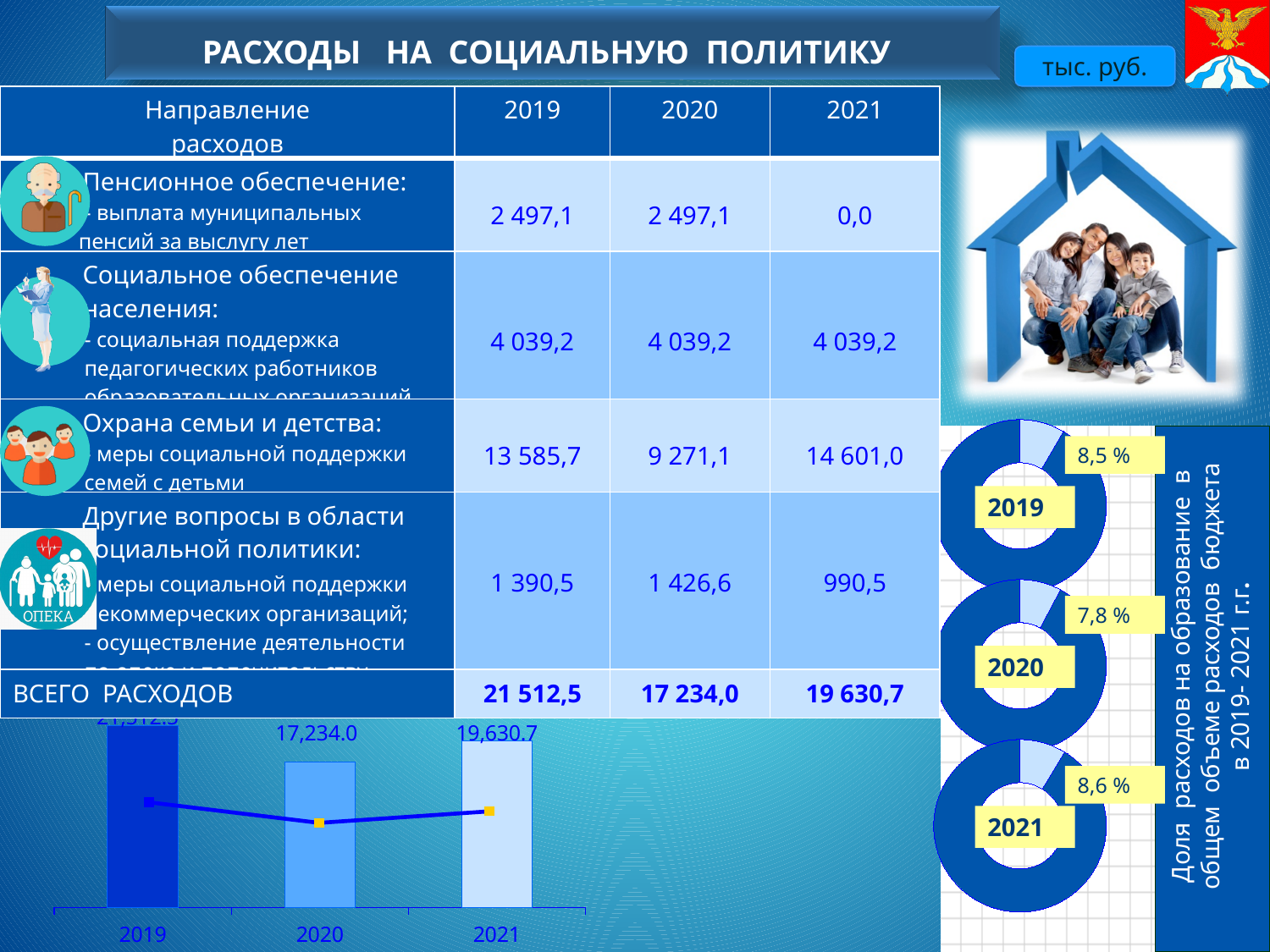
What kind of chart is shown at the bottom left of the slide? bar chart In the bar chart at the bottom left, what is the value for 2021? 19,630.7 In the bar chart at the bottom left, which year has the lowest value? 2020 In the bar chart at the bottom left, which year has the tallest bar? 2019 In the bar chart at the bottom left, what is the value for 2020? 17,234.0 In the bar chart at the bottom left, does the value rise or fall from 2020 to 2021? rise In the bar chart at the bottom left, how many years are shown on the x axis? 3 In the bar chart at the bottom left, what is the difference between the values for 2021 and 2020? 2,396.7 In the donut charts on the right, which year has the lowest share? 2020 In the donut charts on the right, what share is shown for 2020? 7,8 % In the bar chart at the bottom left, which is larger, the value for 2020 or the value for 2021? 2021 In the donut charts on the right, what share is shown for 2019? 8,5 %